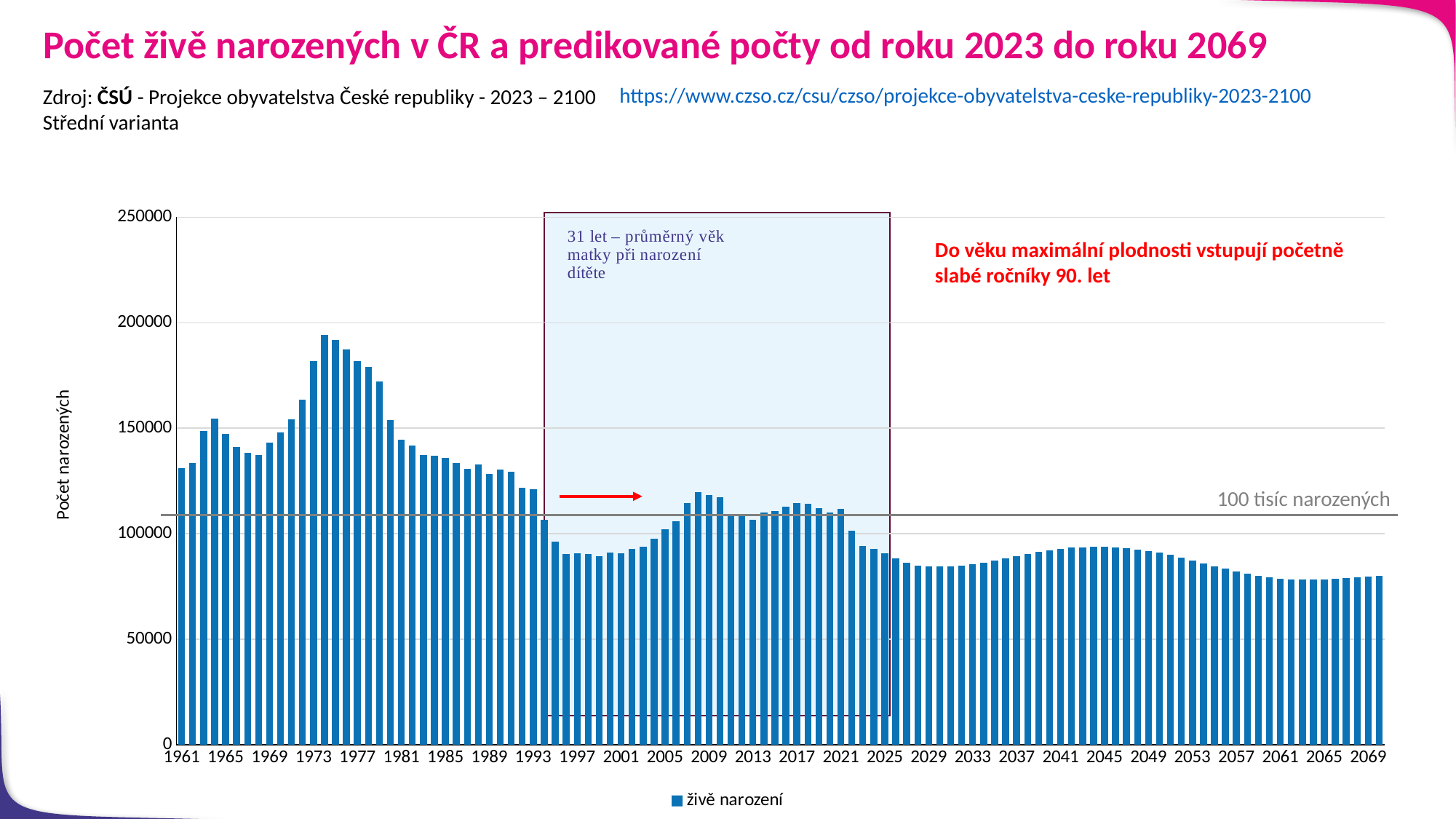
Which year has the larger value, 1977 or 1985? 1977 Do the values rise or fall from 1974 to 1993? fall Is the value for 2069 greater or less than 100000? less What is the legend entry for the series shown in the chart? živě narození How many series does the legend list? 1 Is the value for 1973 greater or less than 150000? greater Is the value for 2009 greater or less than 100000? greater What is the label on the vertical axis of the chart? Počet narozených What kind of chart is shown on the slide? bar chart Which year has the highest number of live births in the chart? 1974